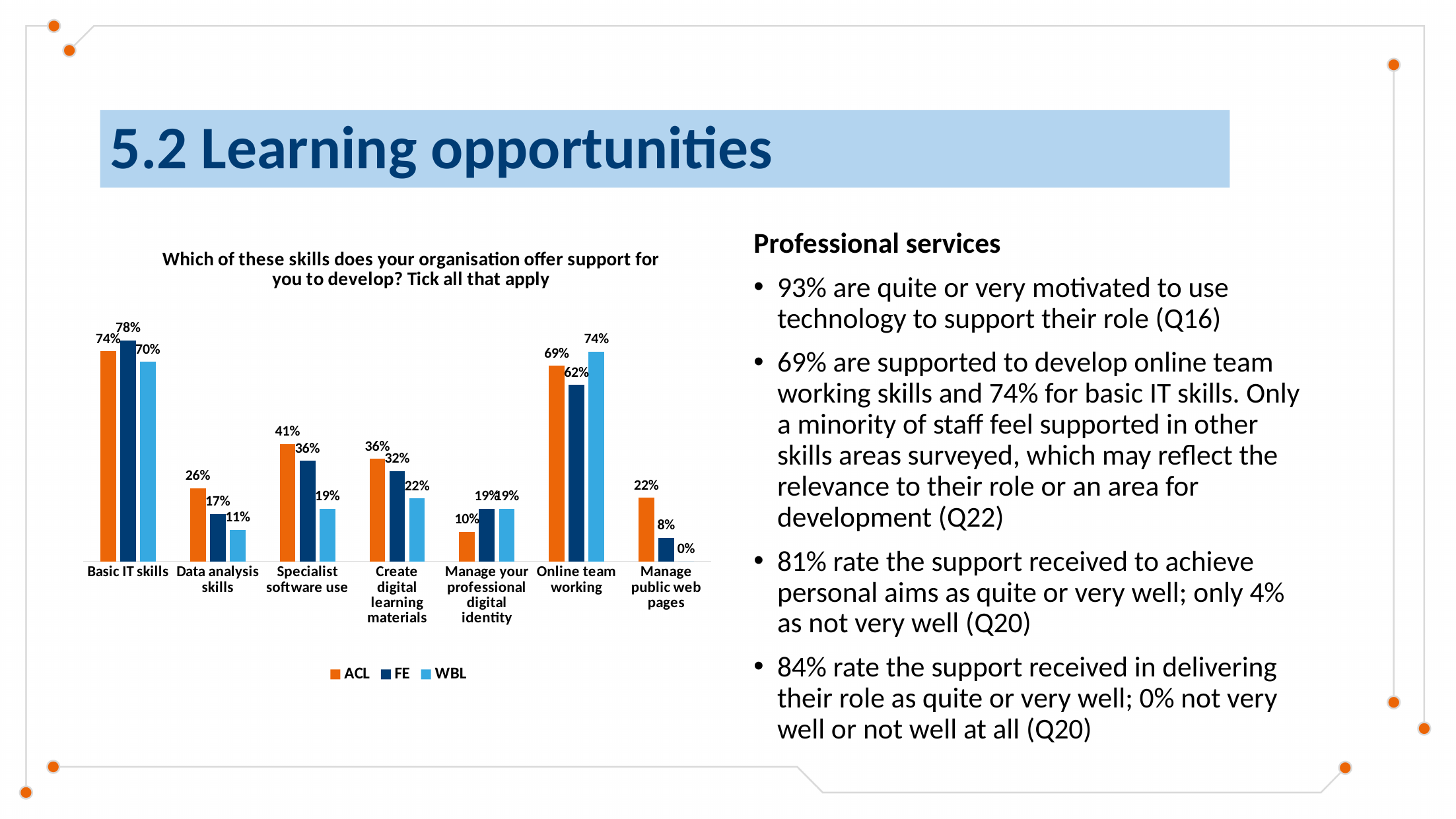
What is the difference between the WBL values for Basic IT skills and Specialist software use? 51% What is the WBL value for Online team working? 74% What is the difference between the ACL and FE values for Data analysis skills? 9% What kind of chart is shown on the slide? Bar chart How many skill categories are shown on the x axis? 7 Which category has the lowest WBL value? Manage public web pages How many series does the legend list? 3 Which is larger for Online team working, the ACL value or the FE value? ACL What is the FE value for Manage public web pages? 8% Which series is shown in orange in the legend? ACL What is the ACL value for Basic IT skills? 74% Which category has the highest FE value? Basic IT skills